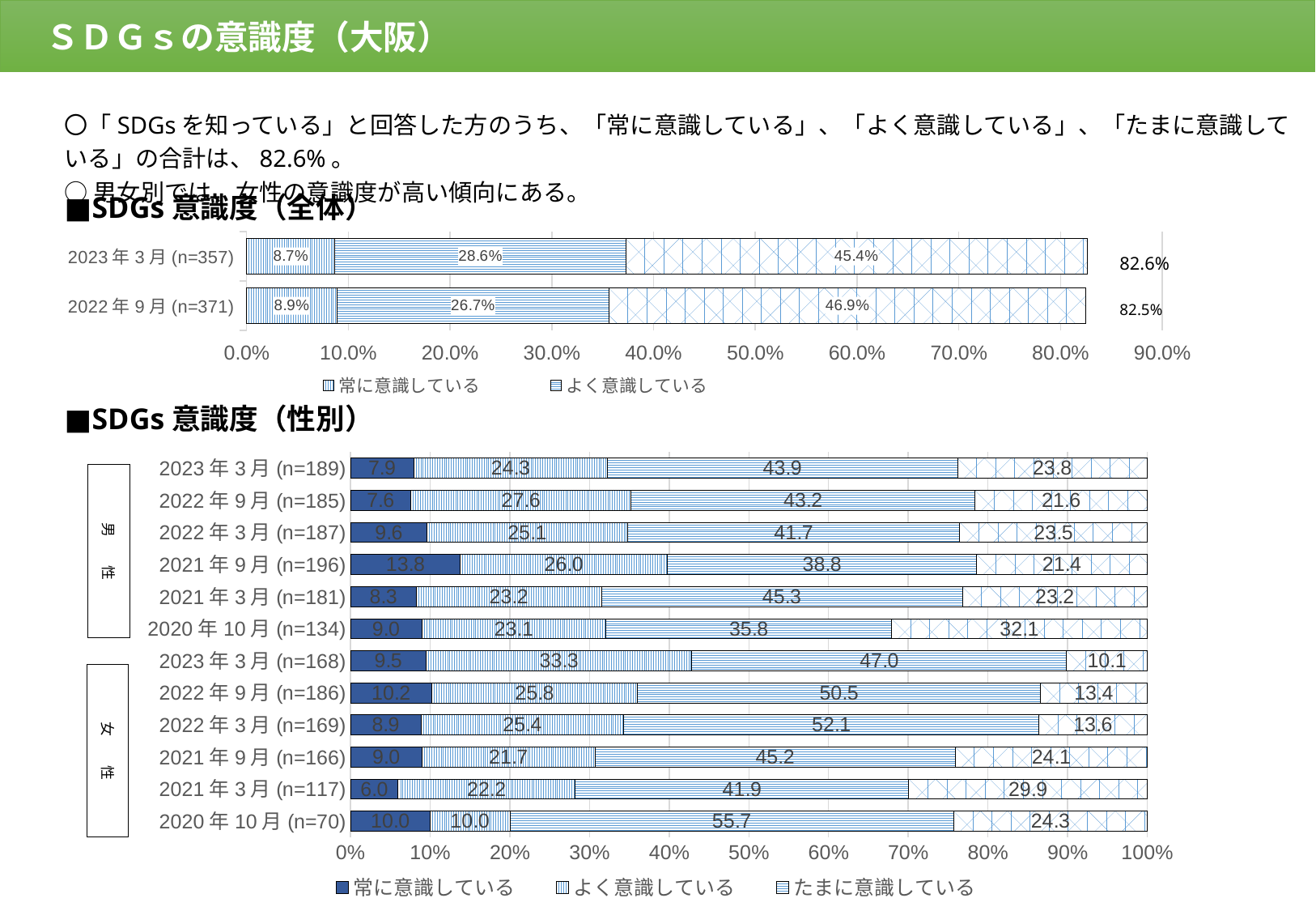
In the SDGs 意識度（性別） chart, which 女性 row has the highest よく意識している value? 2023年3月 (n=168) In the SDGs 意識度（全体） chart, what total is printed at the end of the 2023年3月 (n=357) bar? 82.6% How many series does the legend of the SDGs 意識度（性別） chart list? 3 In the SDGs 意識度（全体） chart, what is the value of 常に意識している for 2023年3月 (n=357)? 8.7% What kind of chart is the SDGs 意識度（性別） chart? Stacked bar chart In the SDGs 意識度（性別） chart, which is larger: the たまに意識している value for 女性 2022年3月 (n=169) or for 男性 2022年3月 (n=187)? 女性 2022年3月 (n=169) In the SDGs 意識度（全体） chart, what is the difference between the third segment values for 2022年9月 (46.9%) and 2023年3月 (45.4%)? 1.5% In the SDGs 意識度（全体） chart, what is the value of よく意識している for 2022年9月 (n=371)? 26.7% In the SDGs 意識度（性別） chart, which 女性 row has the lowest 常に意識している value? 2021年3月 (n=117) In the SDGs 意識度（性別） chart, what is the たまに意識している value for 女性 2020年10月 (n=70)? 55.7 How many bars (rows) are plotted in the SDGs 意識度（性別） chart? 12 In the SDGs 意識度（性別） chart, what is the 常に意識している value for 男性 2021年9月 (n=196)? 13.8